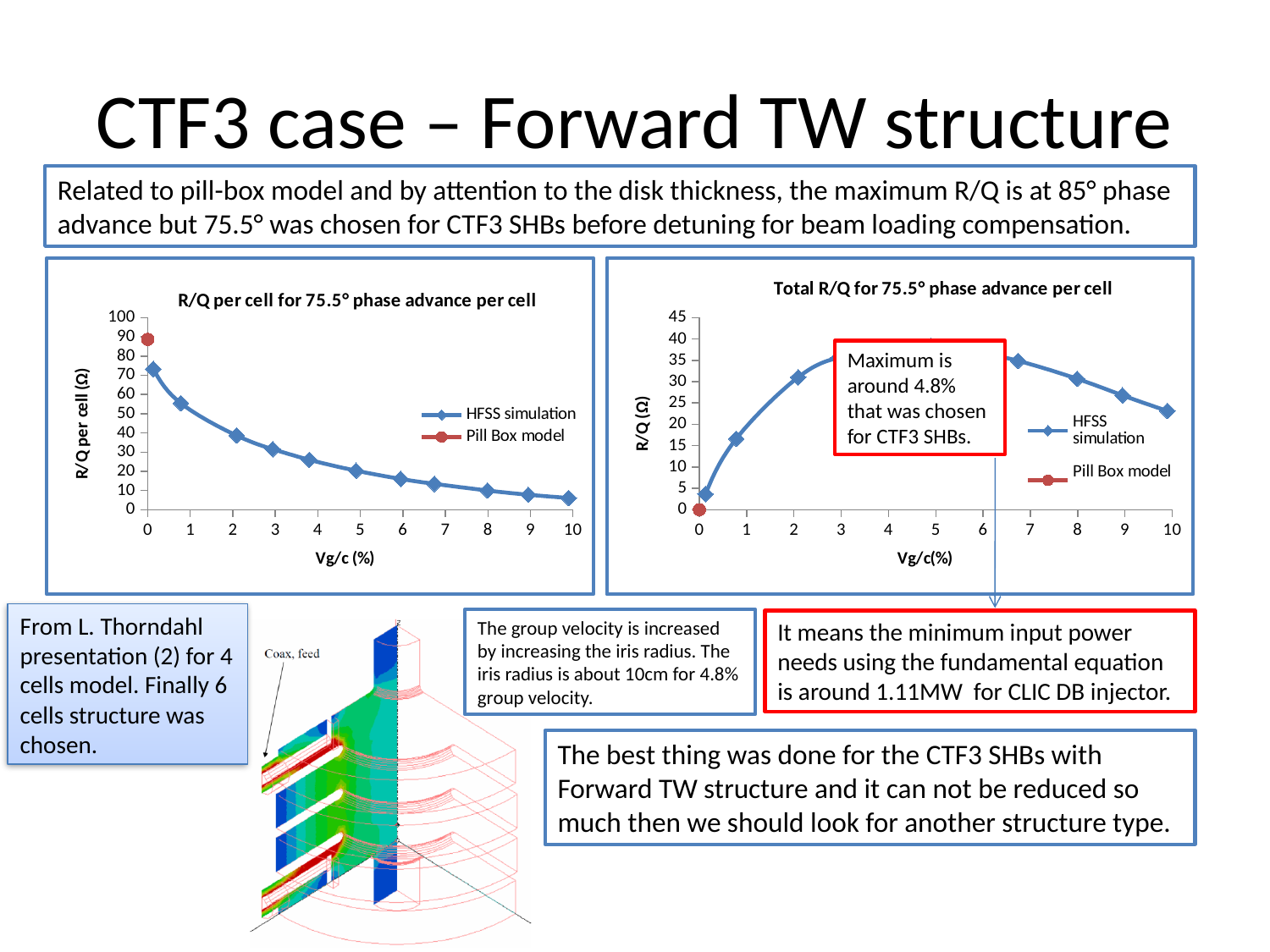
What is the x-axis label of the right chart 'Total R/Q for 75.5° phase advance per cell'? Vg/c(%) In the right chart 'Total R/Q for 75.5° phase advance per cell', is the HFSS simulation value at Vg/c of about 10% greater or less than 20? greater What is the title of the right chart on the slide? Total R/Q for 75.5° phase advance per cell In the right chart 'Total R/Q for 75.5° phase advance per cell', around what Vg/c value does the annotation say the maximum occurs? around 4.8% In the left chart 'R/Q per cell for 75.5° phase advance per cell', do the HFSS simulation values rise or fall as Vg/c (%) increases? fall In the right chart 'Total R/Q for 75.5° phase advance per cell', which is larger at Vg/c near 0: the HFSS simulation value or the Pill Box model value? HFSS simulation What kind of chart is the left chart titled 'R/Q per cell for 75.5° phase advance per cell'? line chart In the left chart 'R/Q per cell for 75.5° phase advance per cell', which is larger at Vg/c near 0: the Pill Box model value or the HFSS simulation value? Pill Box model In the left chart 'R/Q per cell for 75.5° phase advance per cell', is the HFSS simulation value at Vg/c of about 10% greater or less than 10? less In the right chart 'Total R/Q for 75.5° phase advance per cell', is the HFSS simulation value at Vg/c near 0 greater or less than 5? less How many series does the legend of the left chart 'R/Q per cell for 75.5° phase advance per cell' list? 2